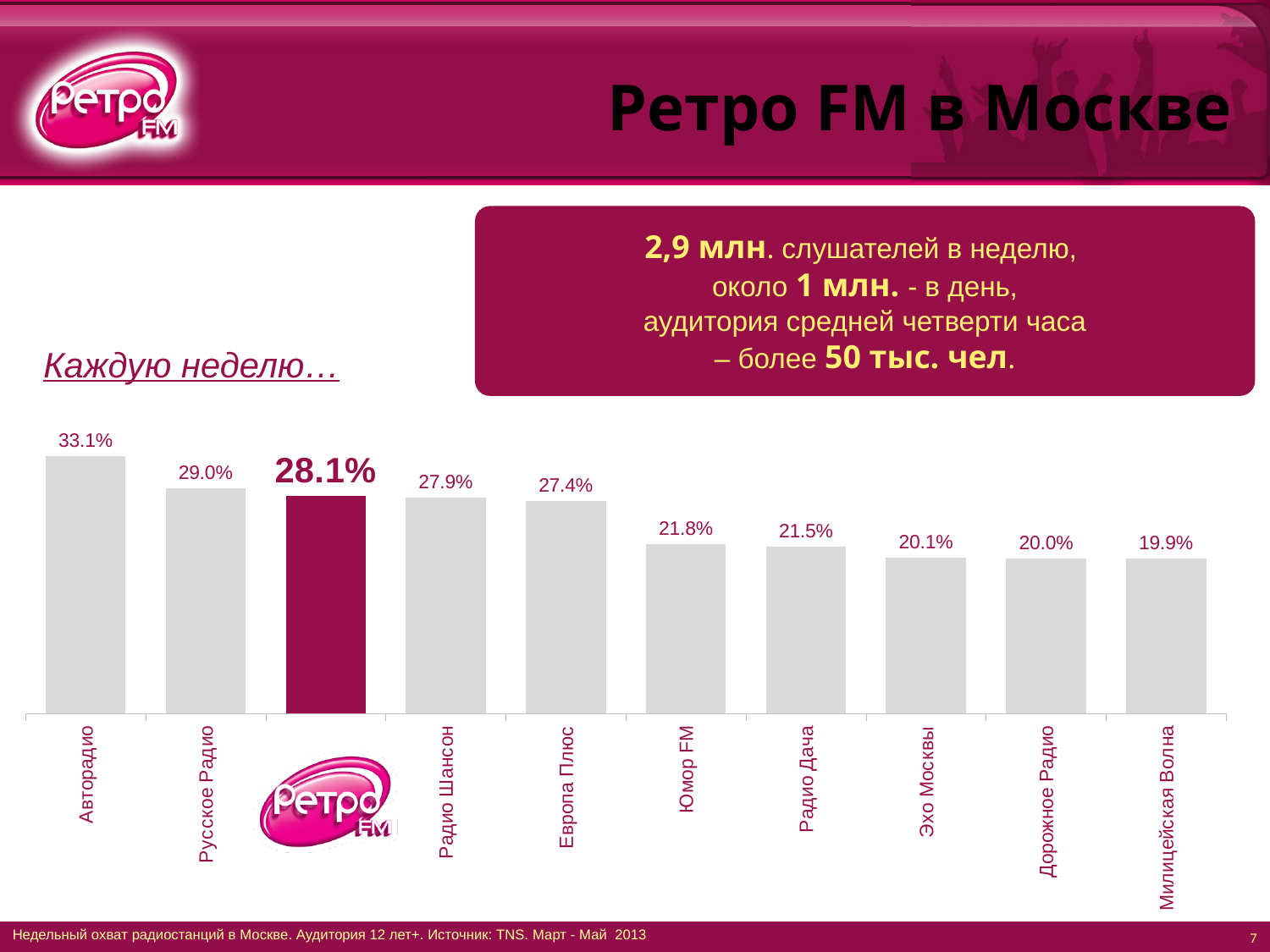
Do the values rise or fall from left to right across the chart? Fall What is the difference between Европа Плюс and Юмор FM? 5.6% How many stations are shown in the chart? 10 Which is larger, Радио Шансон or Радио Дача? Радио Шансон What kind of chart is shown? Bar chart What is the value for Авторадио? 33.1% What is the value for Русское Радио? 29.0% Which station has the lowest value? Милицейская Волна What is the value for the highlighted Ретро FM bar? 28.1% What is the difference between Авторадио and Ретро FM? 5.0% What is the value for Эхо Москвы? 20.1% Which station has the highest value? Авторадио